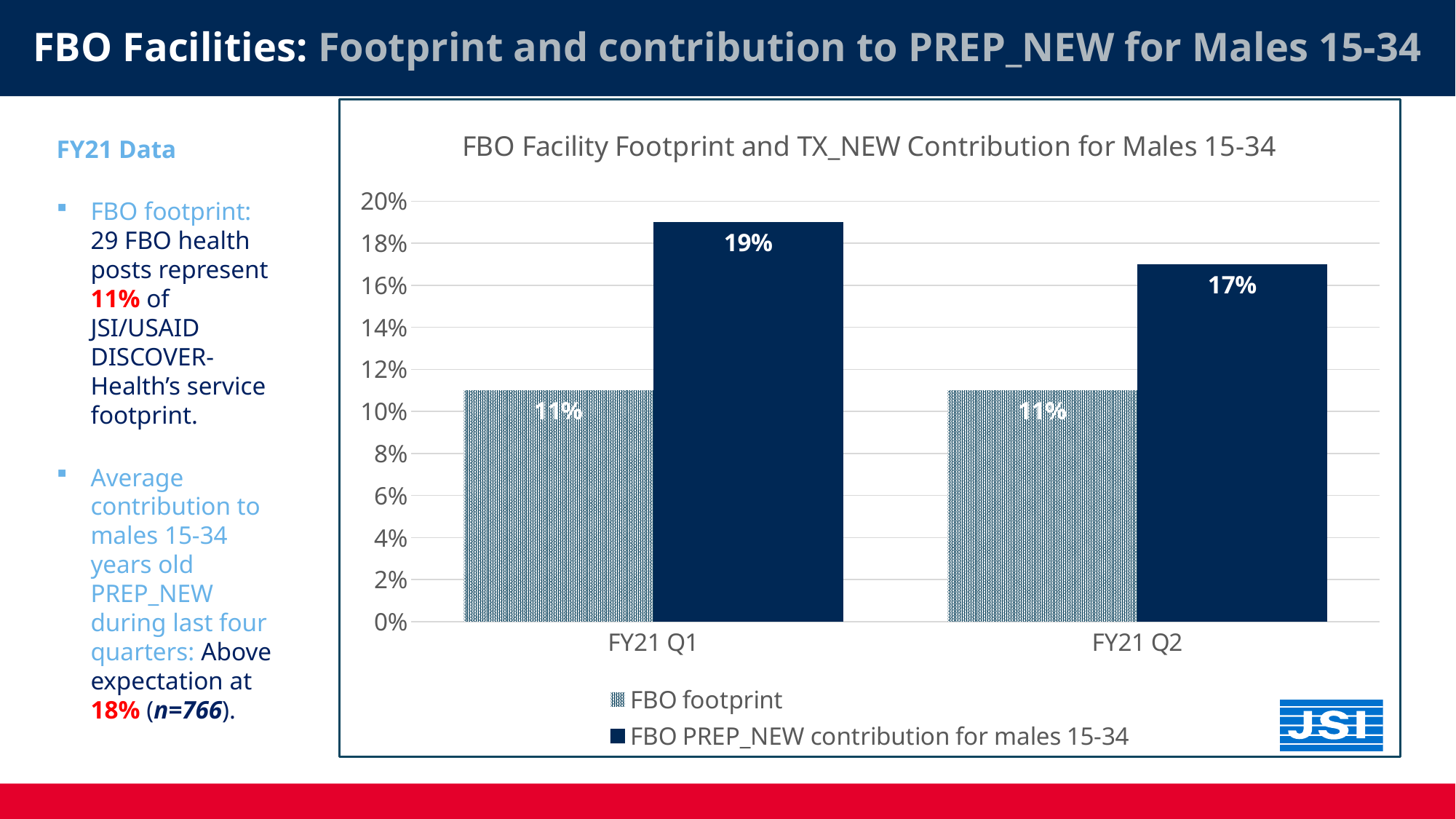
What is the FBO PREP_NEW contribution for males 15-34 in FY21 Q1? 19% What is the FBO footprint value in FY21 Q2? 11% What type of chart is shown on the slide? bar chart What is the difference between the FBO PREP_NEW contribution for males 15-34 in FY21 Q1 and FY21 Q2? 2% In which quarter is the FBO PREP_NEW contribution for males 15-34 highest? FY21 Q1 What is the FBO footprint value in FY21 Q1? 11% In FY21 Q1, which is larger: the FBO footprint or the FBO PREP_NEW contribution for males 15-34? FBO PREP_NEW contribution for males 15-34 How many quarters are shown on the x axis of the chart? 2 In FY21 Q2, how much higher is the FBO PREP_NEW contribution for males 15-34 than the FBO footprint? 6% What is the FBO PREP_NEW contribution for males 15-34 in FY21 Q2? 17% Does the FBO PREP_NEW contribution for males 15-34 rise or fall from FY21 Q1 to FY21 Q2? fall How many series does the chart legend list? 2